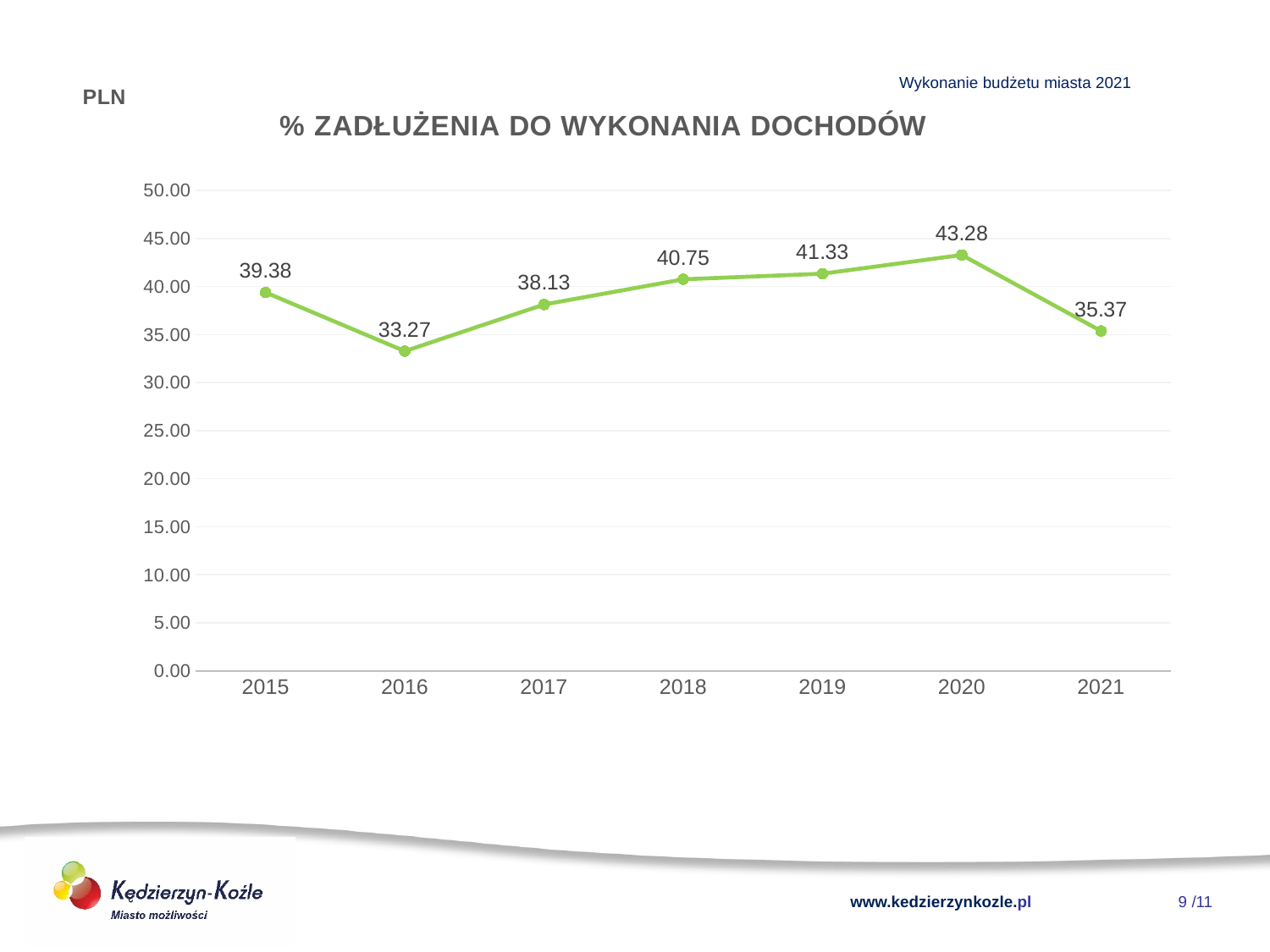
What is the difference between the values for 2015 and 2016? 6.11 Which is larger, the value for 2018 or the value for 2019? 2019 What is the difference between the values for 2020 and 2021? 7.91 What is the value for 2015? 39.38 Is the value for 2017 greater or less than 40.00? less How many years are plotted on the chart? 7 What is the value for 2016? 33.27 Which year has the lowest value? 2016 What is the value for 2021? 35.37 What kind of chart is shown? line chart Which year has the highest value? 2020 Do the values rise or fall from 2016 to 2020? rise